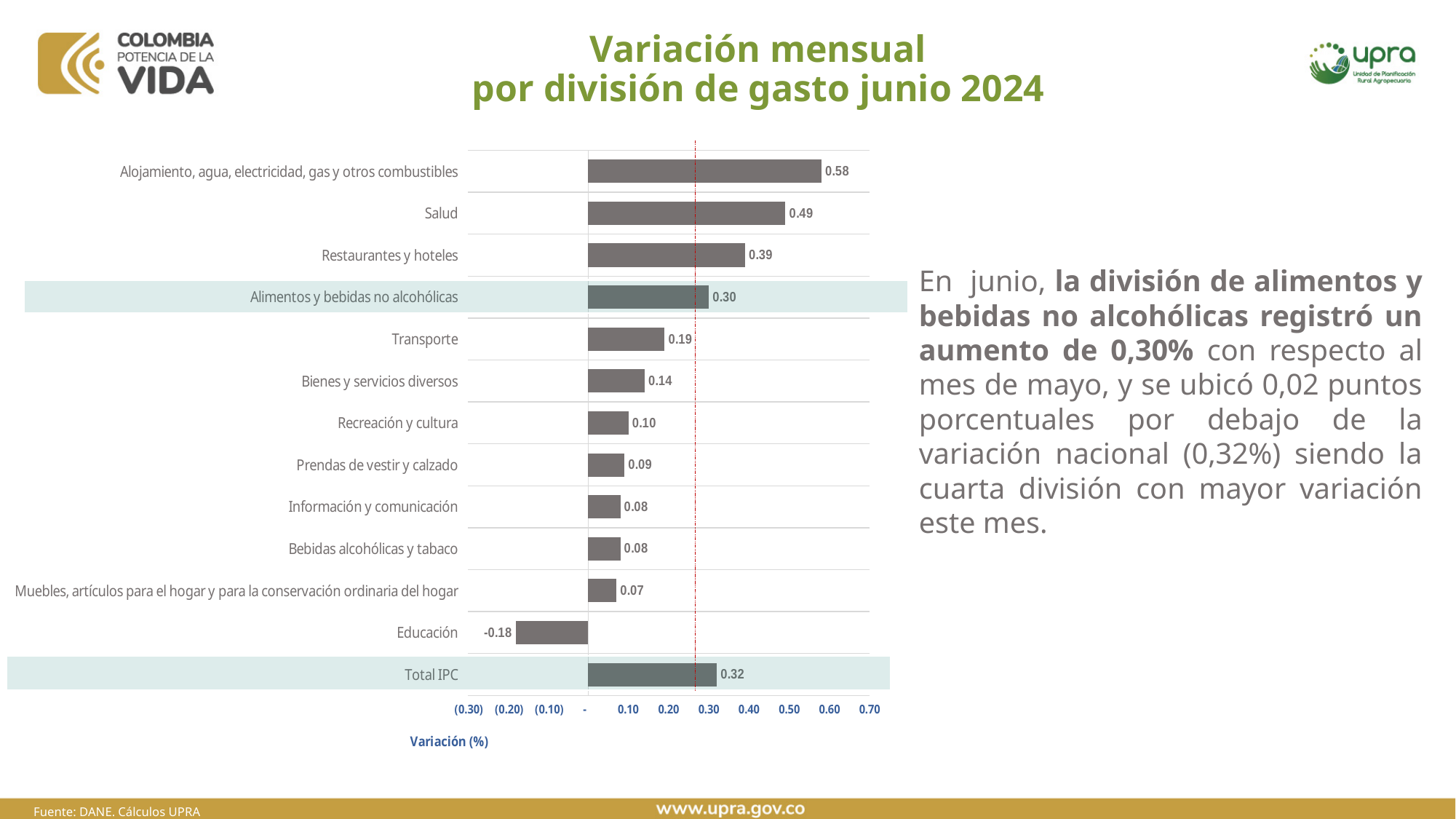
Which is larger, the value for Restaurantes y hoteles or the value for Alimentos y bebidas no alcohólicas? Restaurantes y hoteles How many categories are shown in the chart? 13 What is the value for Total IPC? 0.32 What is the label of the horizontal axis? Variación (%) What is the value for Transporte? 0.19 What kind of chart is shown on the slide? Bar chart Which category has the lowest value? Educación What is the value for Salud? 0.49 What is the value for Educación? -0.18 Which category has the highest value? Alojamiento, agua, electricidad, gas y otros combustibles What is the difference between the values for Alojamiento, agua, electricidad, gas y otros combustibles and Salud? 0.09 What is the title of the chart? Variación mensual por división de gasto junio 2024